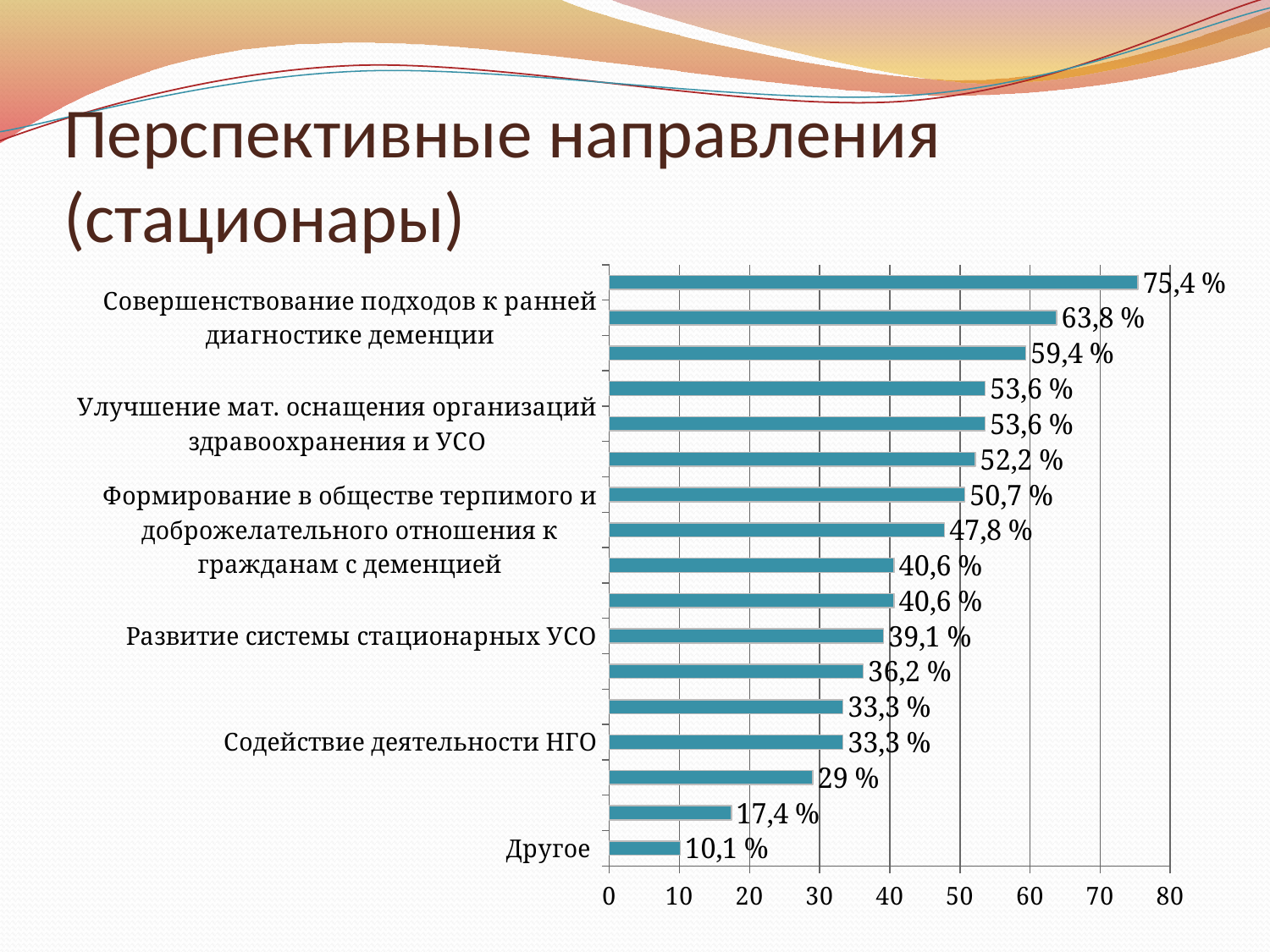
Which is larger: the value for Улучшение мат. оснащения организаций здравоохранения и УСО or the value for Развитие системы стационарных УСО? Улучшение мат. оснащения организаций здравоохранения и УСО How many bars are plotted on the chart? 17 Which category has the lowest value? Другое What is the value for Развитие системы стационарных УСО? 39,1 % What is the value for Улучшение мат. оснащения организаций здравоохранения и УСО? 53,6 % What is the value for Другое? 10,1 % What is the value for Совершенствование подходов к ранней диагностике деменции? 63,8 % What is the title of the slide? Перспективные направления (стационары) What is the value for Содействие деятельности НГО? 33,3 % What is the difference between the values for Развитие системы стационарных УСО and Содействие деятельности НГО? 5,8 % What is the highest value shown on the chart? 75,4 % What kind of chart is shown on the slide? Bar chart